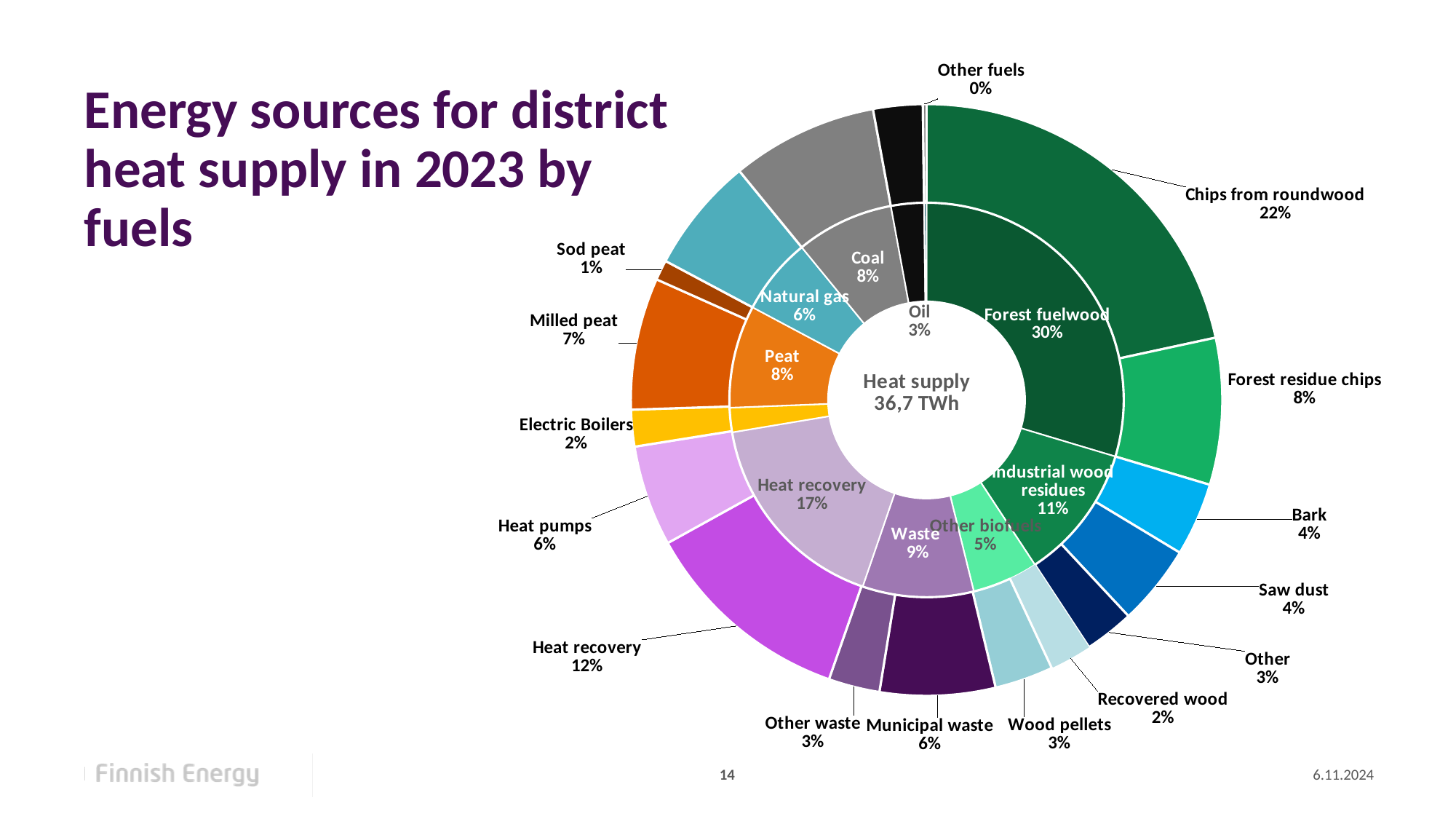
What is the difference in share between Heat recovery (17%) and Waste (9%) in the inner ring? 8 percentage points Which outer-ring category has the largest share of heat supply? Chips from roundwood What is the title of the slide? Energy sources for district heat supply in 2023 by fuels What kind of chart is shown on the slide? Doughnut chart Which inner-ring category has the largest share of heat supply? Forest fuelwood What share of heat supply comes from Heat pumps? 6% What is the total heat supply shown in the centre of the chart? 36,7 TWh What share of heat supply comes from Milled peat? 7% Which has a larger share of heat supply, Coal or Natural gas? Coal What share of heat supply comes from Forest fuelwood in the inner ring? 30% What share of heat supply comes from Chips from roundwood? 22% Which outer-ring category has the smallest share of heat supply? Other fuels